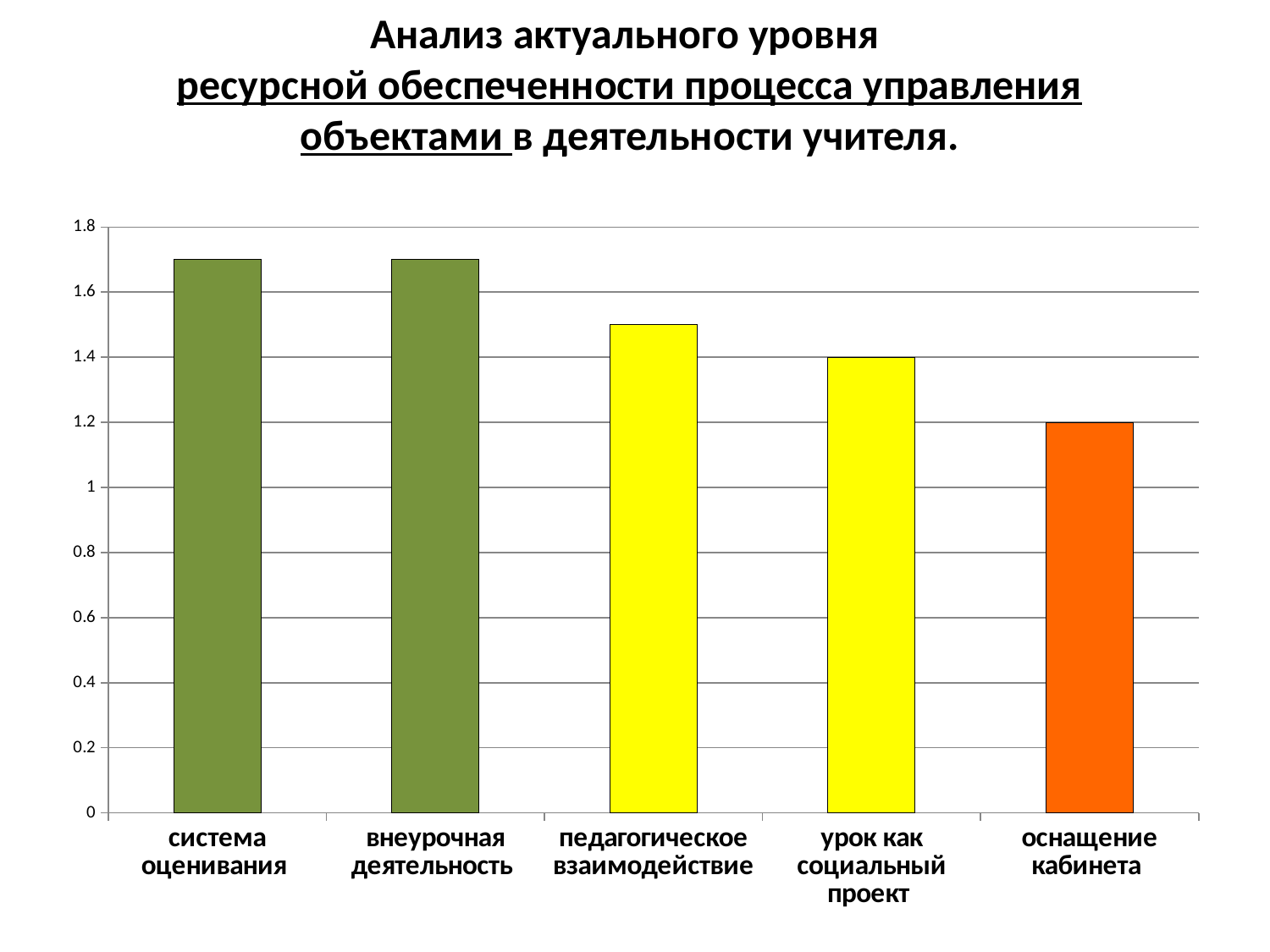
Do the bar values rise or fall from left to right along the x axis? fall Is the value for педагогическое взаимодействие greater or less than 1.6? less Is the value for система оценивания greater or less than 1.6? greater Is the value for внеурочная деятельность greater or less than 1.6? greater What is the value for оснащение кабинета? 1.2 Which is larger, the value for педагогическое взаимодействие or the value for оснащение кабинета? педагогическое взаимодействие Which category has the lowest value in the chart? оснащение кабинета How many categories are shown on the x axis of the chart? 5 What kind of chart is shown on the slide? bar chart What is the value for урок как социальный проект? 1.4 What colour is the bar for оснащение кабинета? orange